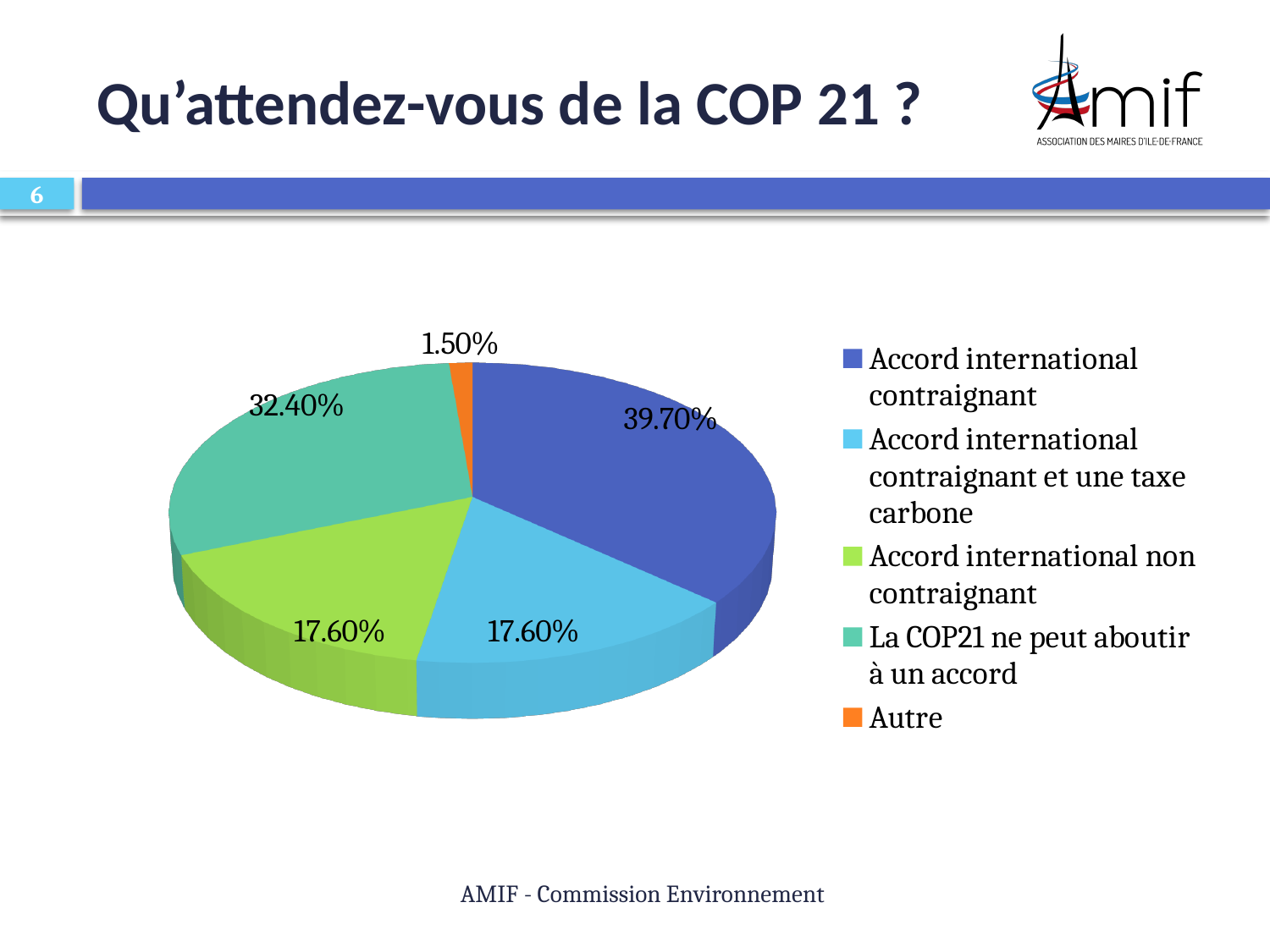
What share of the pie does "La COP21 ne peut aboutir à un accord" represent? 32.40% How many categories does the pie chart have? 5 Which category has the smallest slice of the pie? Autre What is the value for "Accord international non contraignant"? 17.60% Which category has the largest slice of the pie? Accord international contraignant What is the difference between the shares for "Accord international contraignant" and "La COP21 ne peut aboutir à un accord"? 7.30% Which is larger: the share for "La COP21 ne peut aboutir à un accord" or the share for "Accord international contraignant et une taxe carbone"? La COP21 ne peut aboutir à un accord Which colour represents "Autre" in the legend? Orange What is the title of the slide containing the chart? Qu'attendez-vous de la COP 21 ? What kind of chart is shown on the slide? Pie chart What is the value for "Autre"? 1.50% What share of the pie does "Accord international contraignant" represent? 39.70%